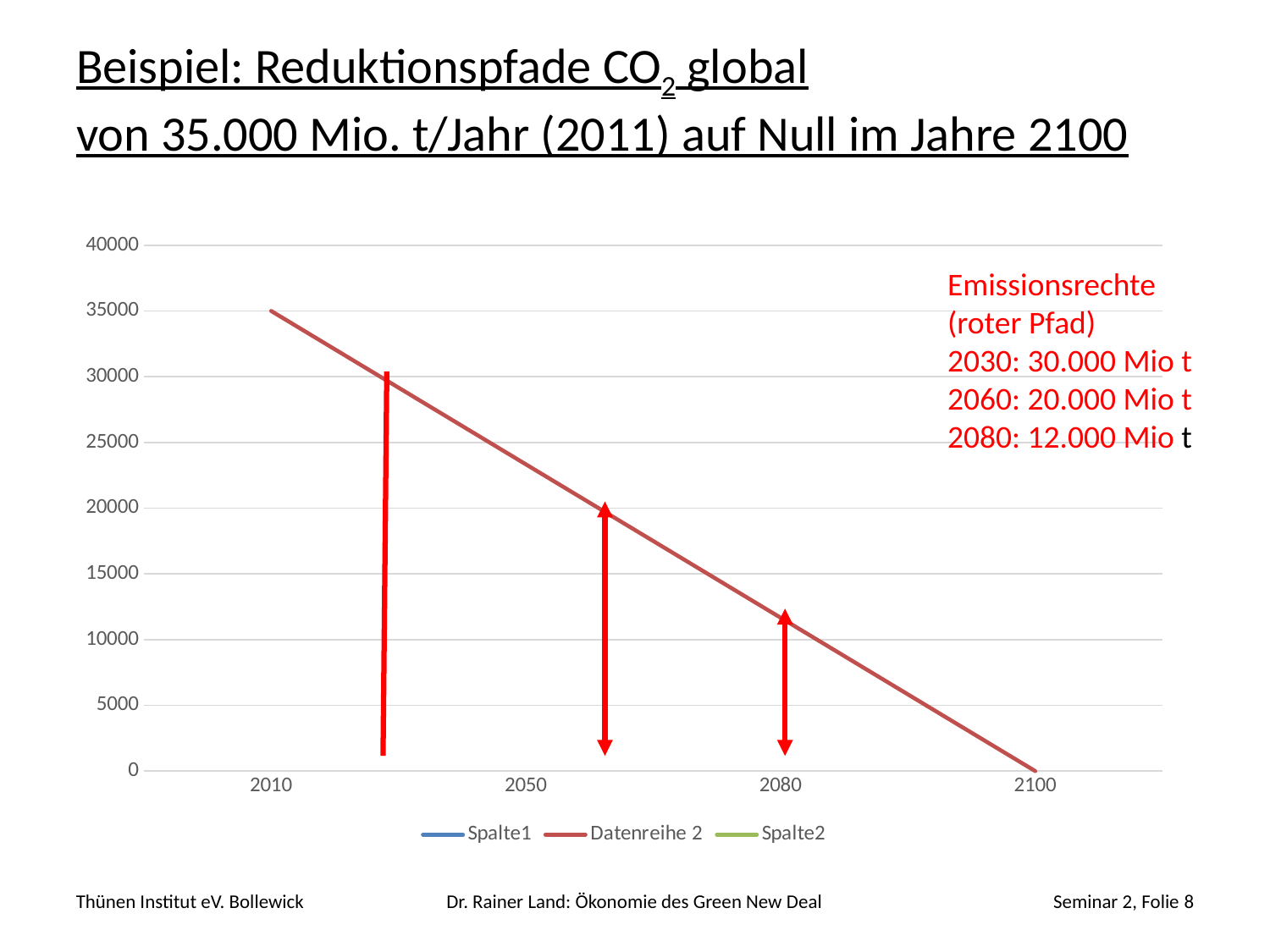
Is the value of the red line at 2050 greater or less than 25000? less Does the red line rise or fall from 2010 to 2100? fall Is the value of the red line at 2080 greater or less than 15000? less What is the value of the red line (Datenreihe 2) at 2010? 35000 Which year on the x axis has the lowest value on the red line? 2100 What kind of chart is shown on the slide? line chart How many series does the legend list? 3 According to the text annotation on the chart, what are the emission rights (Emissionsrechte) for 2060? 20.000 Mio t Which year on the x axis has the highest value on the red line? 2010 How many year labels are shown on the x axis? 4 What is the value of the red line (Datenreihe 2) at 2100? 0 Which is larger, the value of the red line at 2010 or at 2080? 2010